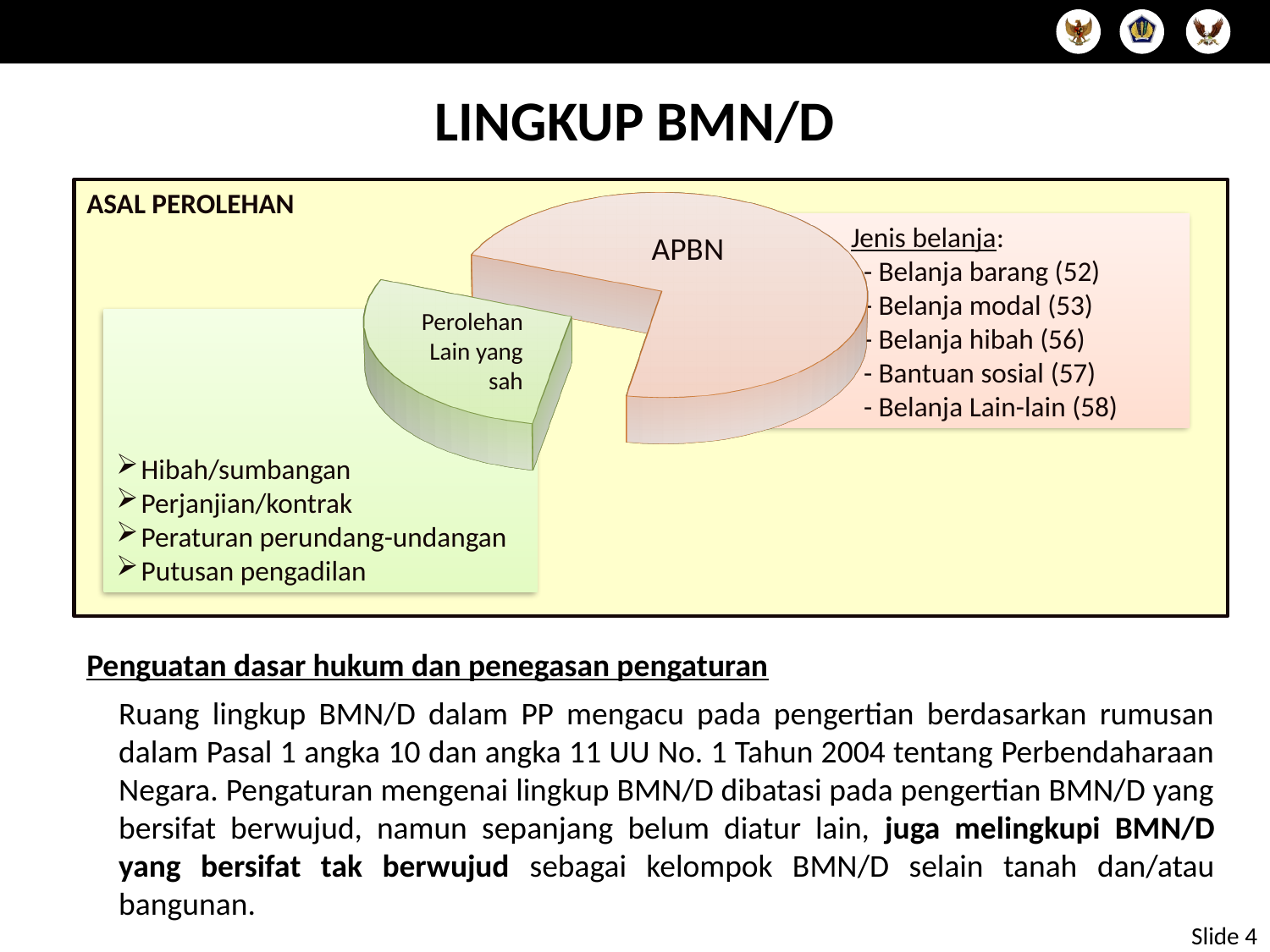
Which slice of the pie chart is the largest? APBN How many slices does the pie chart have? 2 What is the heading of the box containing the pie chart? ASAL PEROLEHAN Which slice is larger, APBN or Perolehan Lain yang sah? APBN Which slice of the pie chart is pulled out (exploded) from the rest of the pie? Perolehan Lain yang sah What kind of chart is shown in the ASAL PEROLEHAN box? Pie chart Which slice of the pie chart is the smallest? Perolehan Lain yang sah What are the labels of the two slices in the pie chart? APBN and Perolehan Lain yang sah